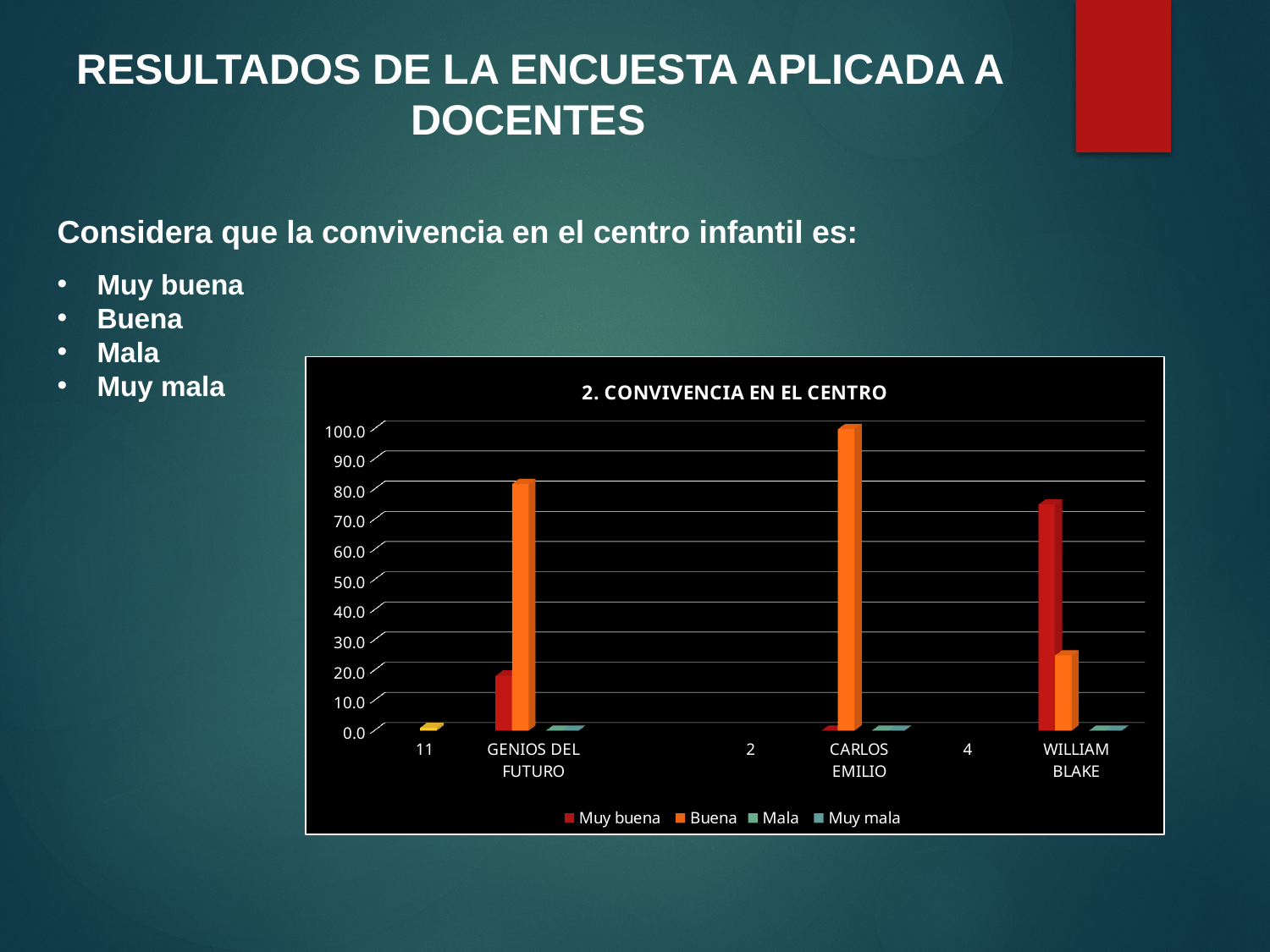
What kind of chart is shown on the slide? bar chart Which category has the highest value for Buena? CARLOS EMILIO Is the value of Buena for WILLIAM BLAKE greater or less than 40? less How many series does the legend of the chart list? 4 What colour represents the Buena series in the legend? orange What is the title of the chart? 2. CONVIVENCIA EN EL CENTRO For GENIOS DEL FUTURO, which is larger: Buena or Muy buena? Buena Is the value of Muy buena for GENIOS DEL FUTURO greater or less than 30? less For WILLIAM BLAKE, which is larger: Muy buena or Buena? Muy buena Is the value of Buena for CARLOS EMILIO greater or less than 90? greater